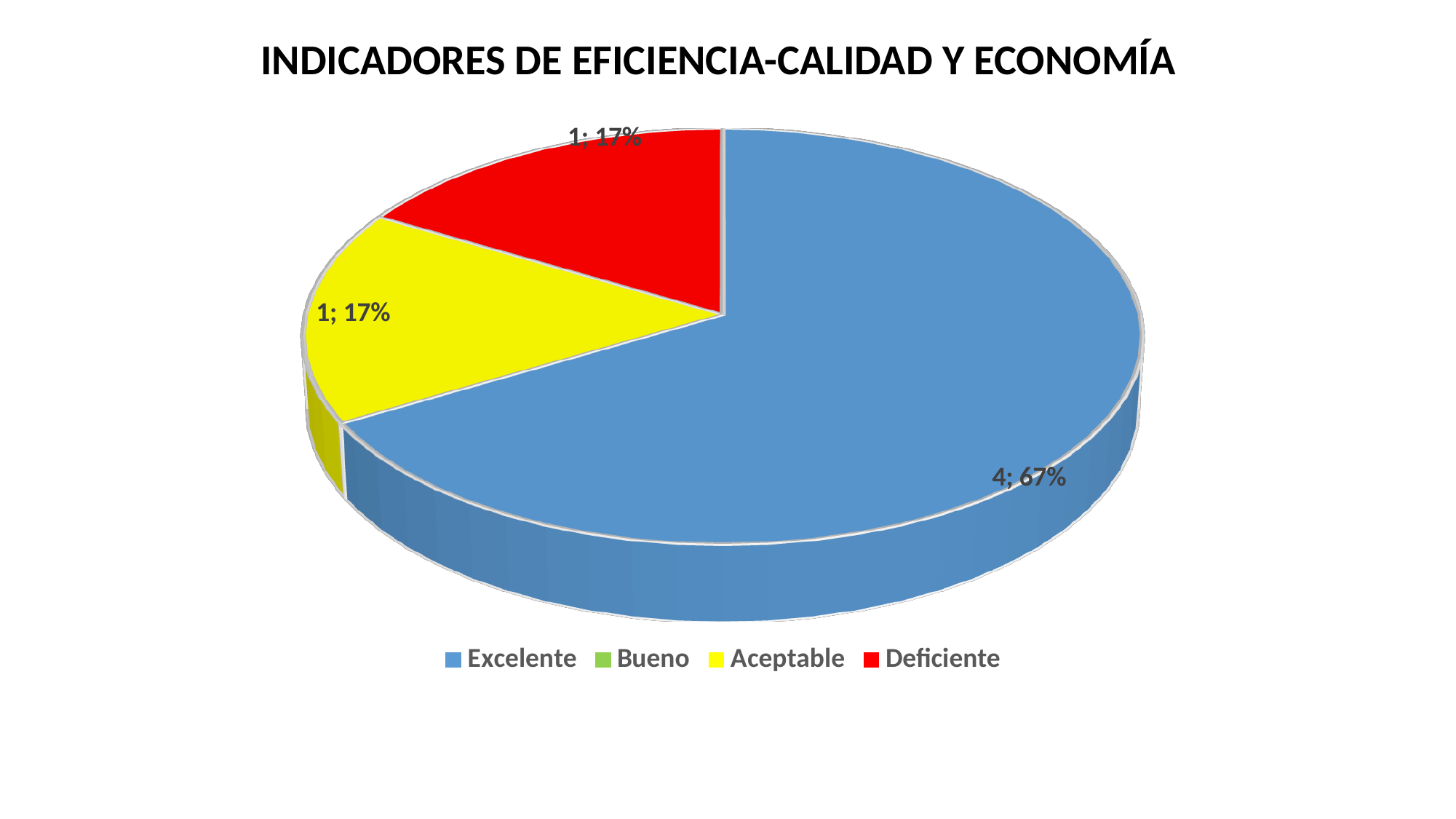
What is the difference between the value for Excelente and the value for Aceptable? 3 How many categories does the legend list? 4 What is the total of the values labelled on the pie slices? 6 What percentage share does the Excelente slice have? 67% Which category has the largest slice of the pie? Excelente What kind of chart is shown on the slide? pie chart What value is labelled on the Excelente slice? 4 What is the title of the chart? INDICADORES DE EFICIENCIA-CALIDAD Y ECONOMÍA Which is larger, the value for Excelente or the value for Deficiente? Excelente What colour is the Deficiente slice? red What percentage share does the Deficiente slice have? 17% What value is labelled on the Aceptable slice? 1